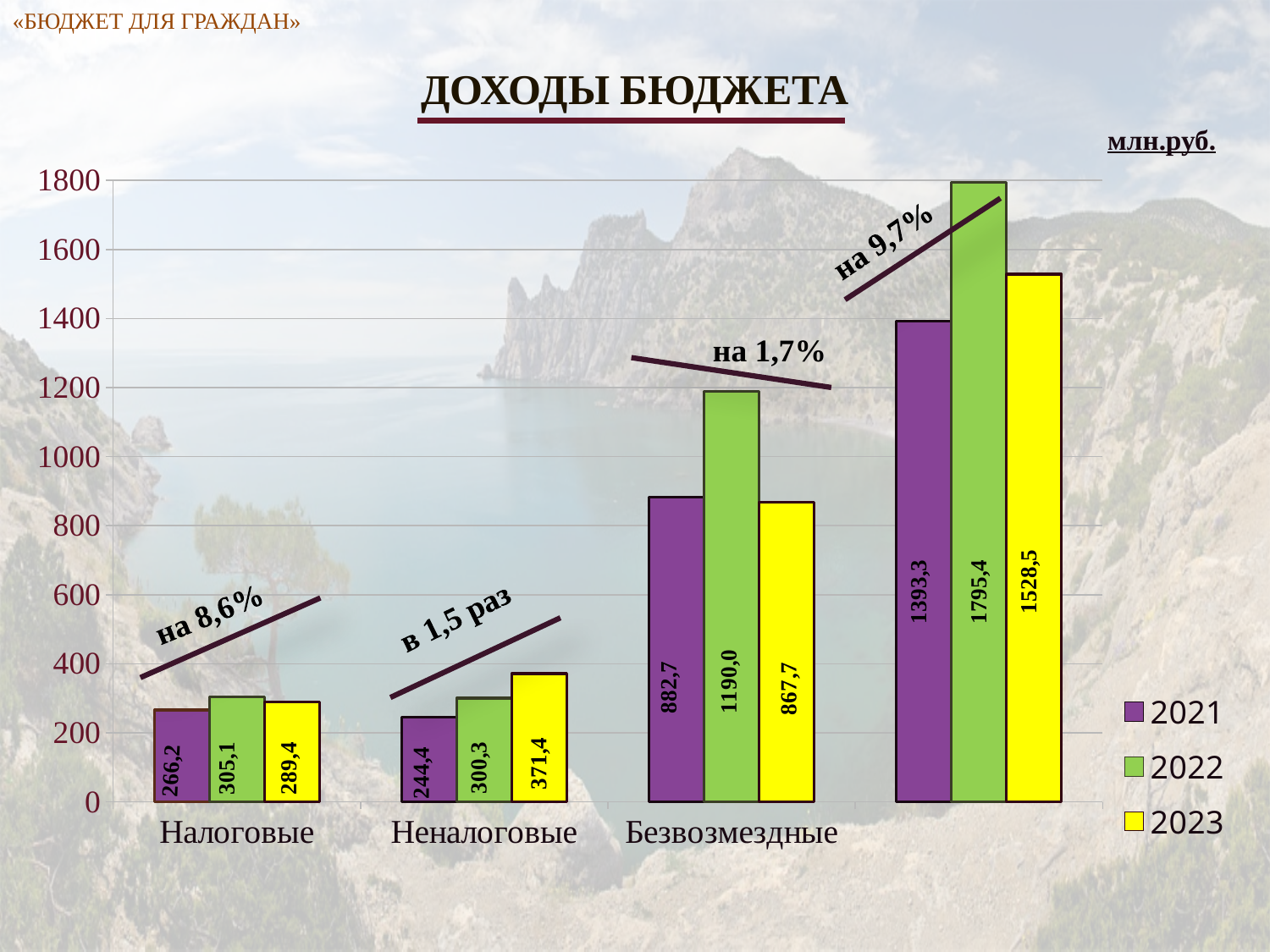
Do the Неналоговые values rise or fall from 2021 to 2023? rise For Безвозмездные, which year has the highest value? 2022 What is the value for Неналоговые in 2023? 371,4 Is the value for Безвозмездные in 2022 greater or less than 1000? greater By how much does the Неналоговые value in 2023 exceed the value in 2021? 127,0 For Неналоговые, which year has the lowest value? 2021 How many series does the legend list? 3 What is the difference between the Безвозмездные values for 2022 and 2021? 307,3 What is the value for Налоговые in 2022? 305,1 What is the value for Безвозмездные in 2021? 882,7 What kind of chart is shown on the slide? bar chart Which is larger in 2023: Налоговые or Неналоговые? Неналоговые